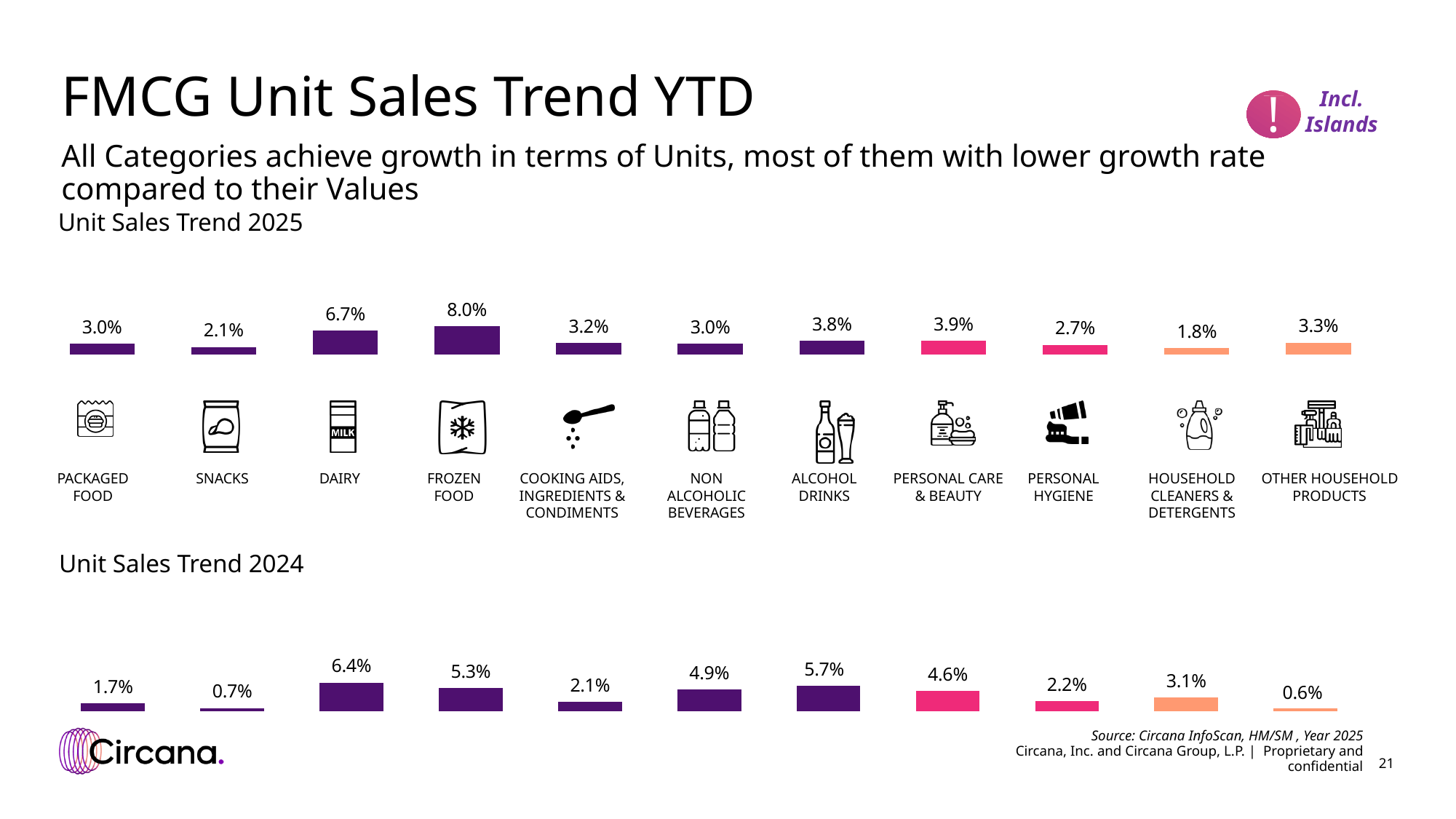
In the Unit Sales Trend 2025 chart, what is the value for Frozen Food? 8.0% In the Unit Sales Trend 2024 chart, which category has the highest value? Dairy What kind of chart is the Unit Sales Trend 2024 chart? Bar chart How many categories are shown in the Unit Sales Trend 2025 chart? 11 In the Unit Sales Trend 2024 chart, what is the value for Dairy? 6.4% In the Unit Sales Trend 2024 chart, which category has the lowest value? Other Household Products In the Unit Sales Trend 2025 chart, which category has the highest value? Frozen Food In the Unit Sales Trend 2024 chart, which is larger: Alcohol Drinks or Non Alcoholic Beverages? Alcohol Drinks In the Unit Sales Trend 2025 chart, what is the difference between Frozen Food and Snacks? 5.9% In the Unit Sales Trend 2025 chart, what is the value for Personal Care & Beauty? 3.9% In the Unit Sales Trend 2024 chart, what is the difference between Household Cleaners & Detergents and Other Household Products? 2.5% In the Unit Sales Trend 2025 chart, which category has the lowest value? Household Cleaners & Detergents